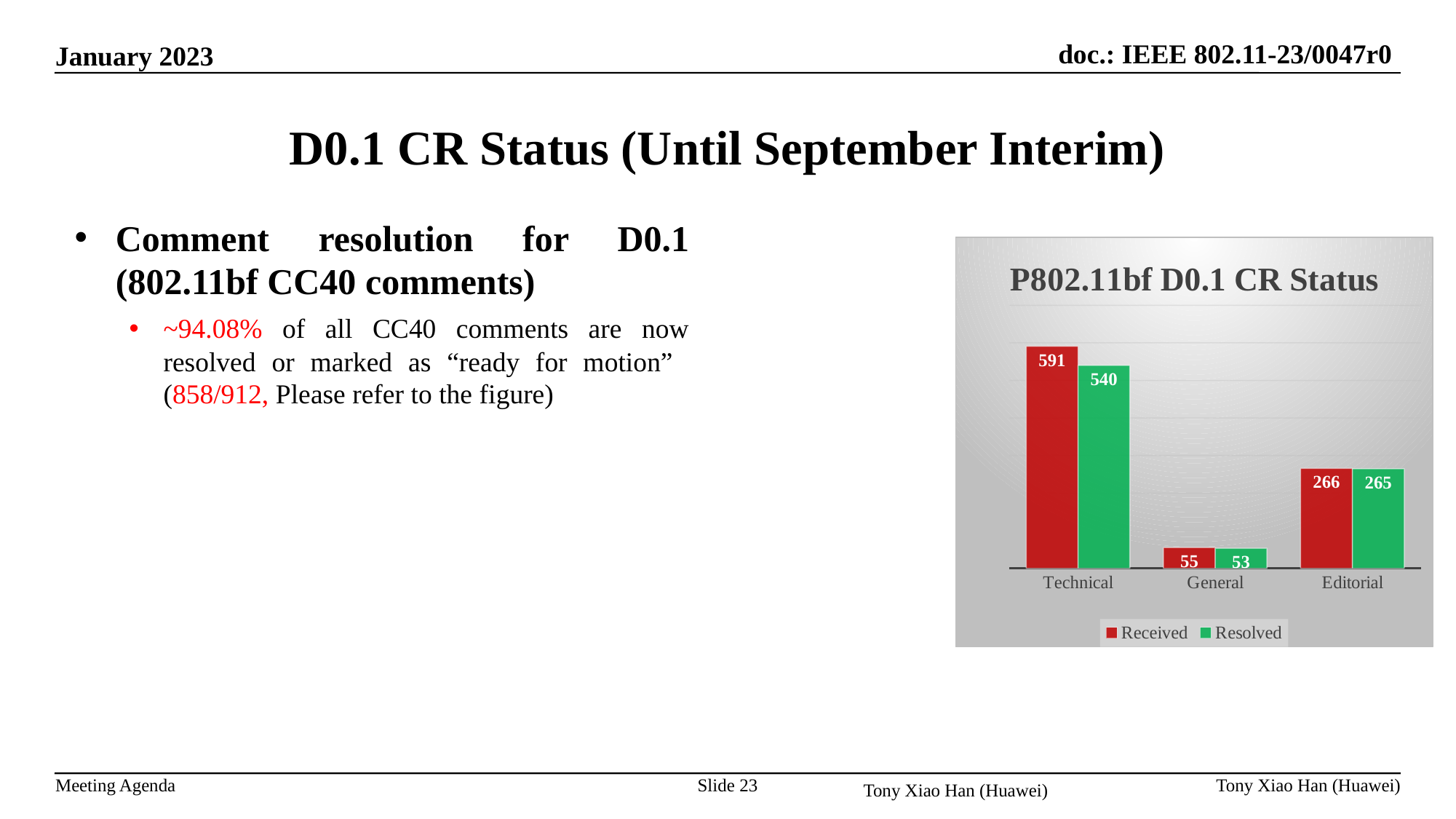
What kind of chart is shown on the slide? Bar chart How many series does the legend list? 2 What is the difference between Received and Resolved for Technical? 51 What is the Received value for Technical? 591 Which category has the lowest Resolved value? General What is the title of the chart? P802.11bf D0.1 CR Status What is the Resolved value for General? 53 Which category has the highest Received value? Technical What is the Resolved value for Editorial? 265 How many categories are shown on the x axis? 3 What is the difference between Received and Resolved for General? 2 Which is larger, the Received value for Editorial or the Received value for General? Editorial